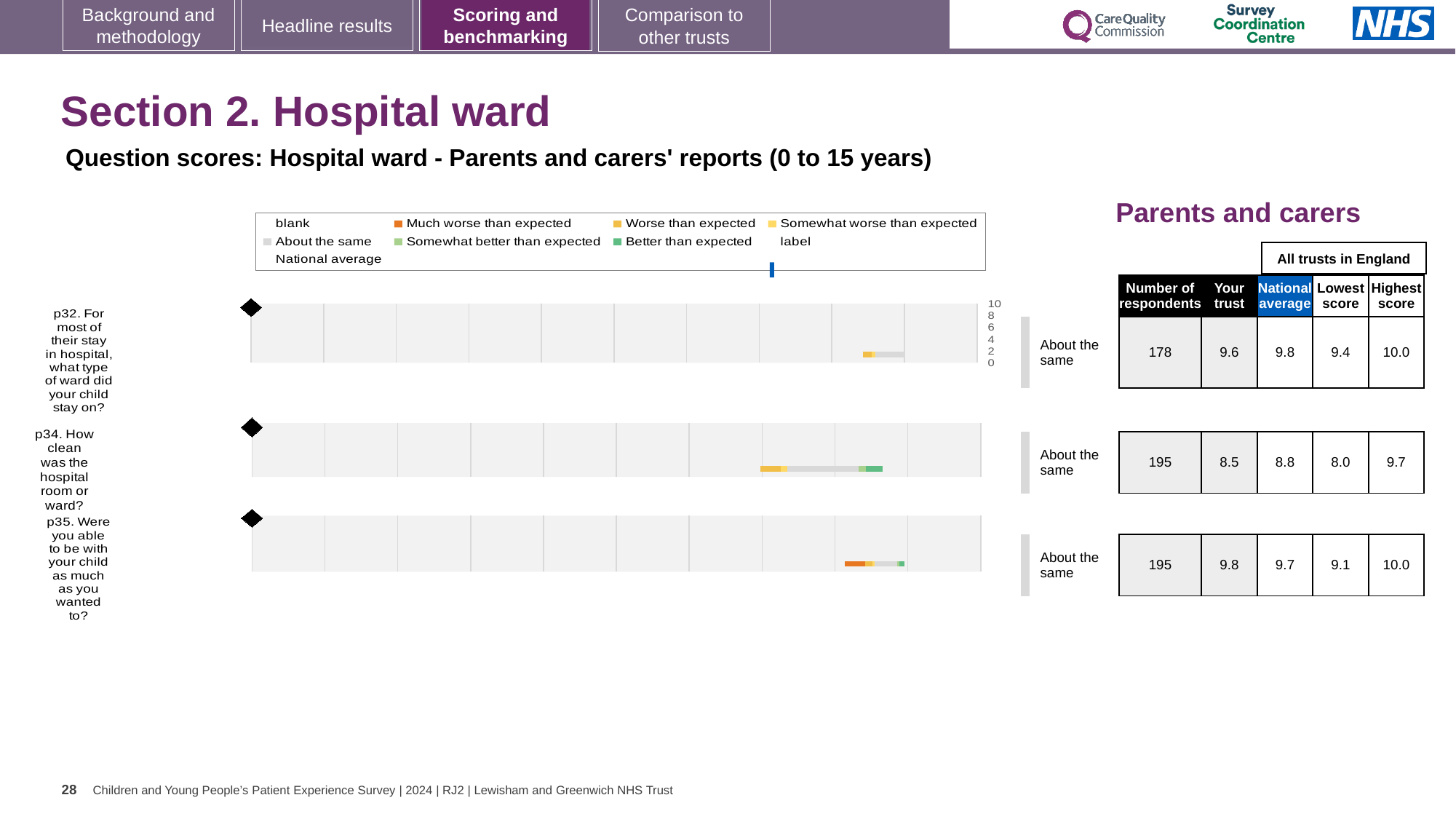
For p35, which is larger: the 'Your trust' score or the national average? Your trust What is the national average score for p35 (Were you able to be with your child as much as you wanted to?)? 9.7 What is the 'Your trust' score for p34 (How clean was the hospital room or ward?)? 8.5 What is the lowest score among all trusts in England for p35? 9.1 What benchmark category is shown for p32? About the same How many questions are charted on this slide? 3 What is the highest score among all trusts in England for p34? 9.7 Which question has the highest 'Your trust' score on this slide? p35 What is the difference between the national average and the 'Your trust' score for p34? 0.3 How many respondents answered p32 (what type of ward did your child stay on)? 178 Which question has the lowest 'Your trust' score on this slide? p34 What kind of chart is used to show the question scores? Bar chart